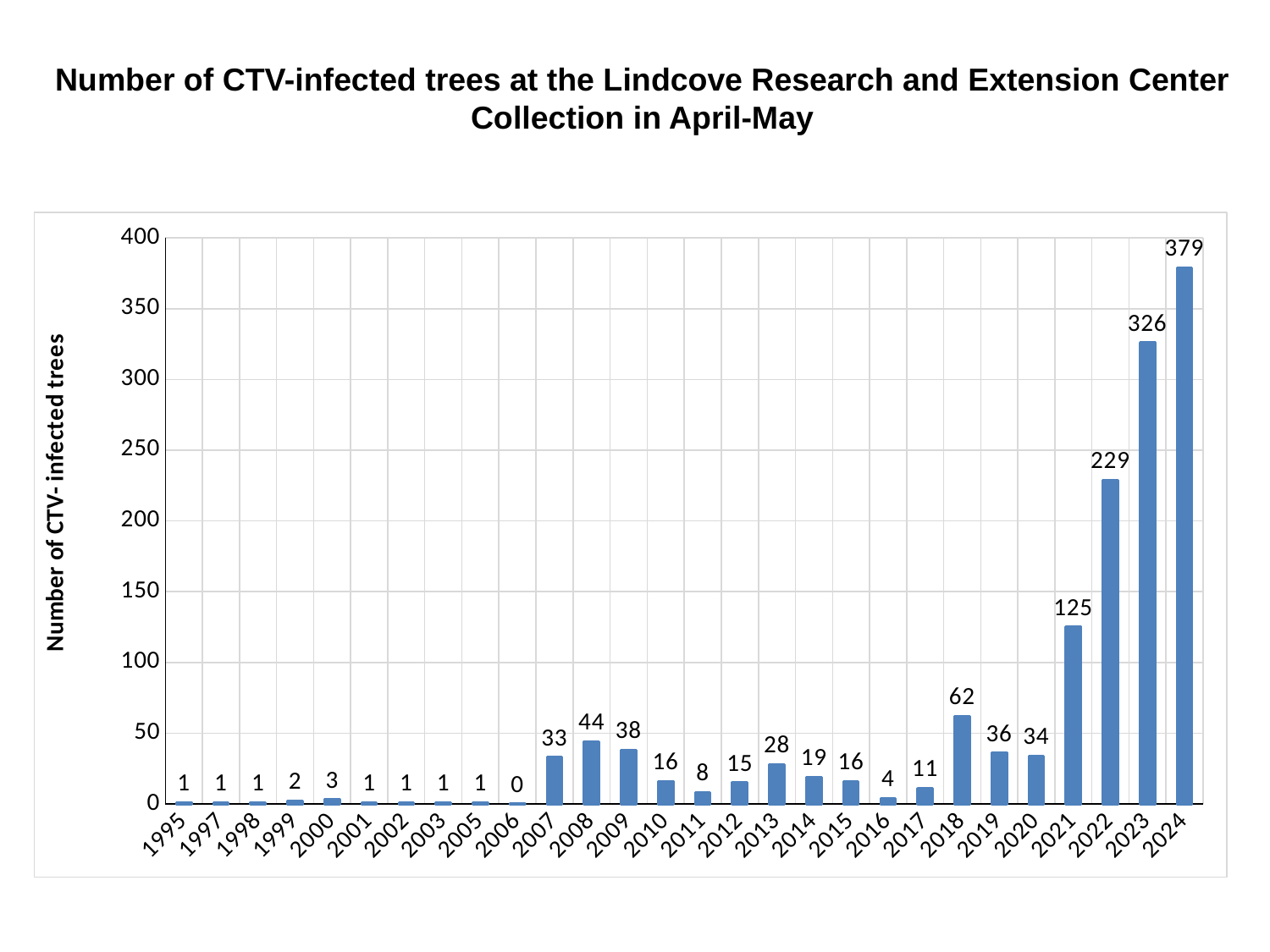
How many years are shown on the x axis? 28 Which year has more CTV-infected trees, 2009 or 2013? 2009 What is the difference in the number of CTV-infected trees between 2022 and 2021? 104 Which year has the highest number of CTV-infected trees? 2024 Which year has the lowest number of CTV-infected trees? 2006 What is the difference in the number of CTV-infected trees between 2024 and 2023? 53 What kind of chart is shown on the slide? Bar chart What is the label of the y axis? Number of CTV- infected trees What is the number of CTV-infected trees in 2018? 62 What is the number of CTV-infected trees in 2008? 44 Is the value for 2022 greater or less than 200? greater What is the number of CTV-infected trees in 2024? 379